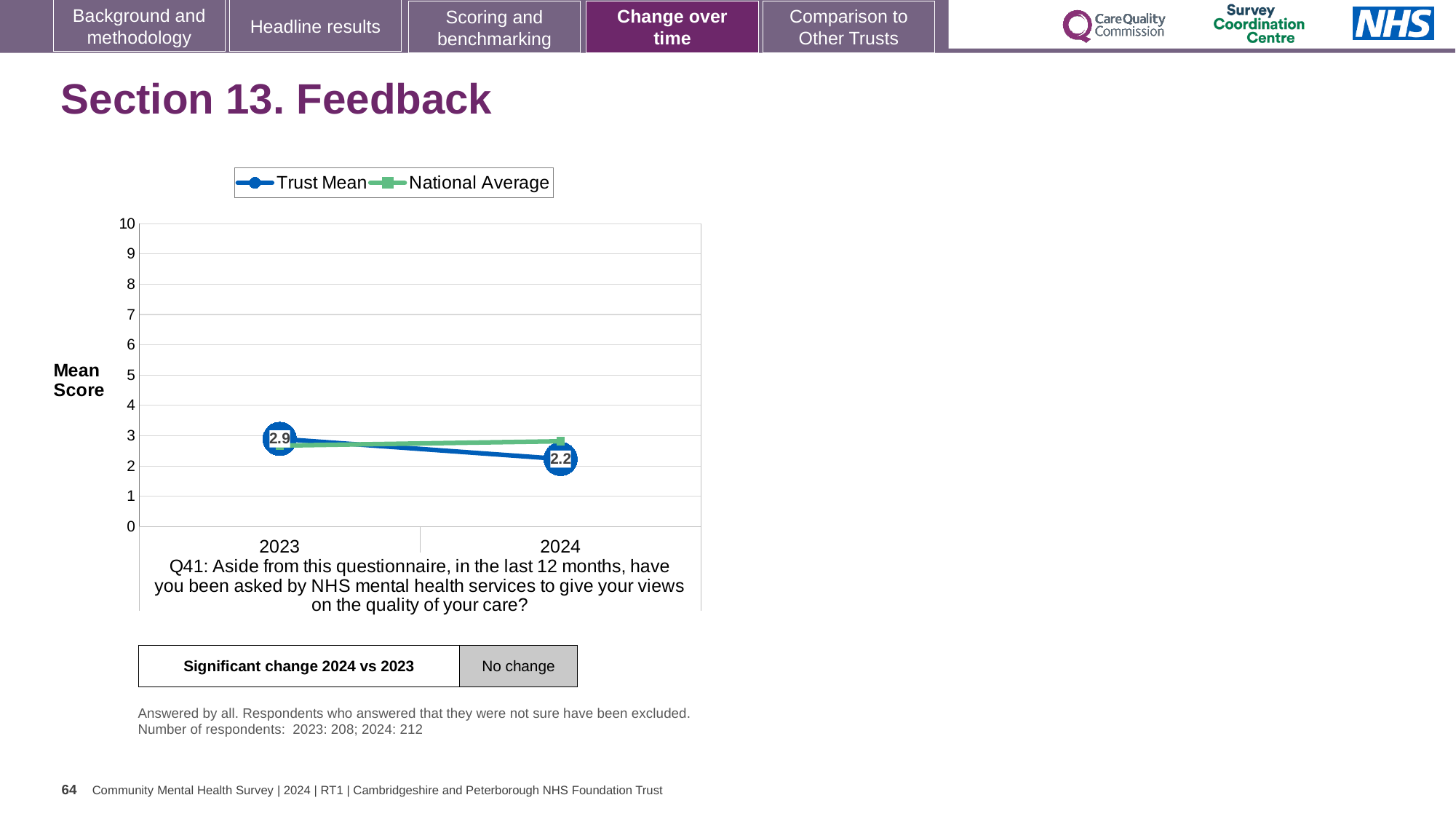
By how much did the Trust Mean score change from 2023 to 2024? 0.7 In which year is the Trust Mean score lower? 2024 What kind of chart is shown on the slide? line chart In which year is the Trust Mean score higher? 2023 What is the Trust Mean score for 2023? 2.9 Does the Trust Mean rise or fall from 2023 to 2024? fall How many years are plotted on the x axis? 2 What is the label on the y axis of the chart? Mean Score How many series does the legend list? 2 Is the National Average value for 2024 greater or less than 5? less In 2024, which is larger: the Trust Mean or the National Average? National Average What is the Trust Mean score for 2024? 2.2